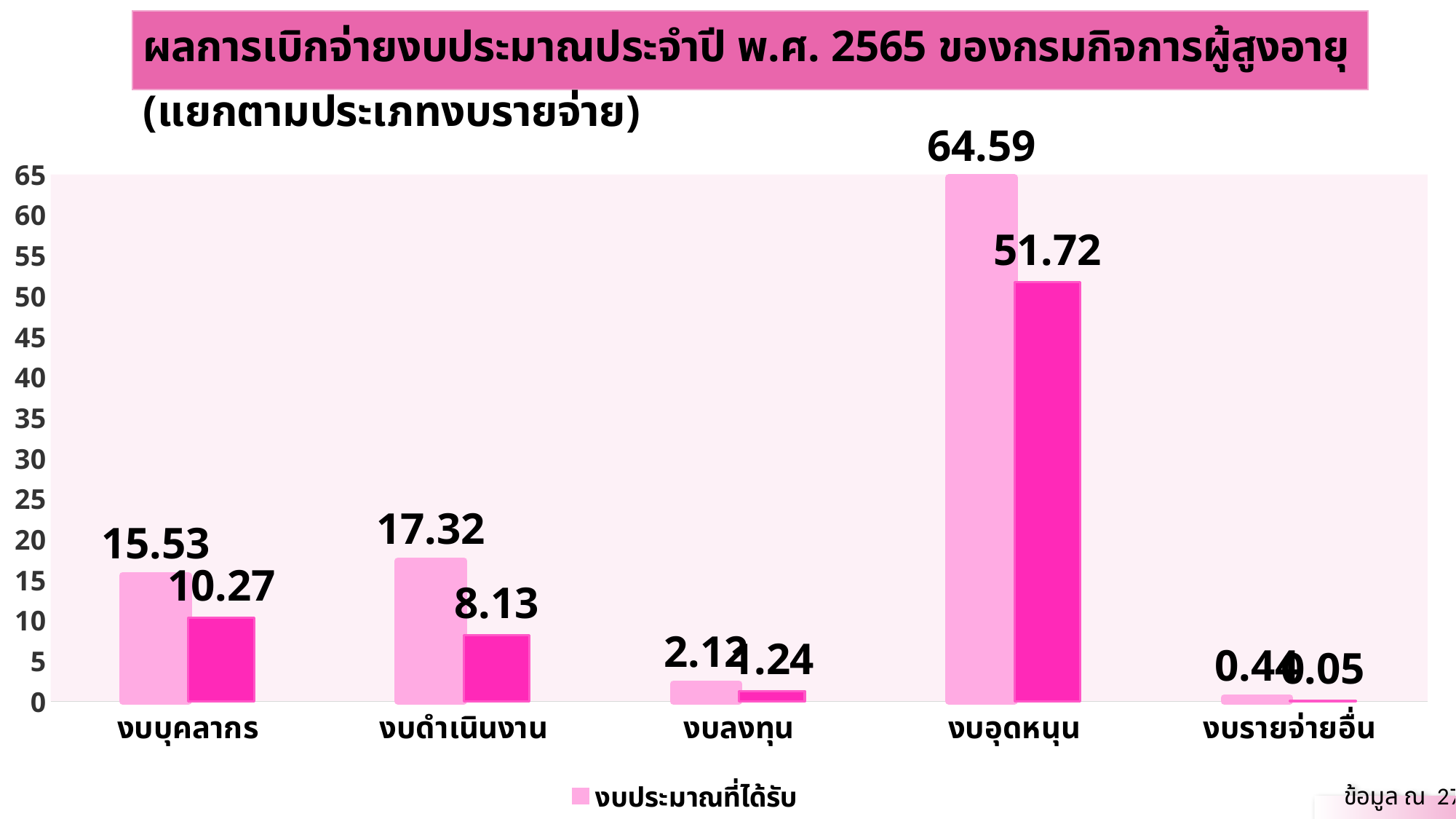
What kind of chart is shown on the slide? Bar chart Which category has the lowest งบประมาณที่ได้รับ value? งบรายจ่ายอื่น How many categories are shown on the x axis? 5 What value is shown on the dark pink bar for งบดำเนินงาน? 8.13 What value is shown on the dark pink bar for งบอุดหนุน? 51.72 What is the งบประมาณที่ได้รับ value for งบอุดหนุน? 64.59 What value is shown on the dark pink bar for งบบุคลากร? 10.27 Which category has the highest งบประมาณที่ได้รับ value? งบอุดหนุน What is the งบประมาณที่ได้รับ value for งบดำเนินงาน? 17.32 What is the งบประมาณที่ได้รับ value for งบบุคลากร? 15.53 Which has the larger งบประมาณที่ได้รับ value, งบบุคลากร or งบดำเนินงาน? งบดำเนินงาน What is the difference between the light pink and dark pink bars for งบอุดหนุน? 12.87